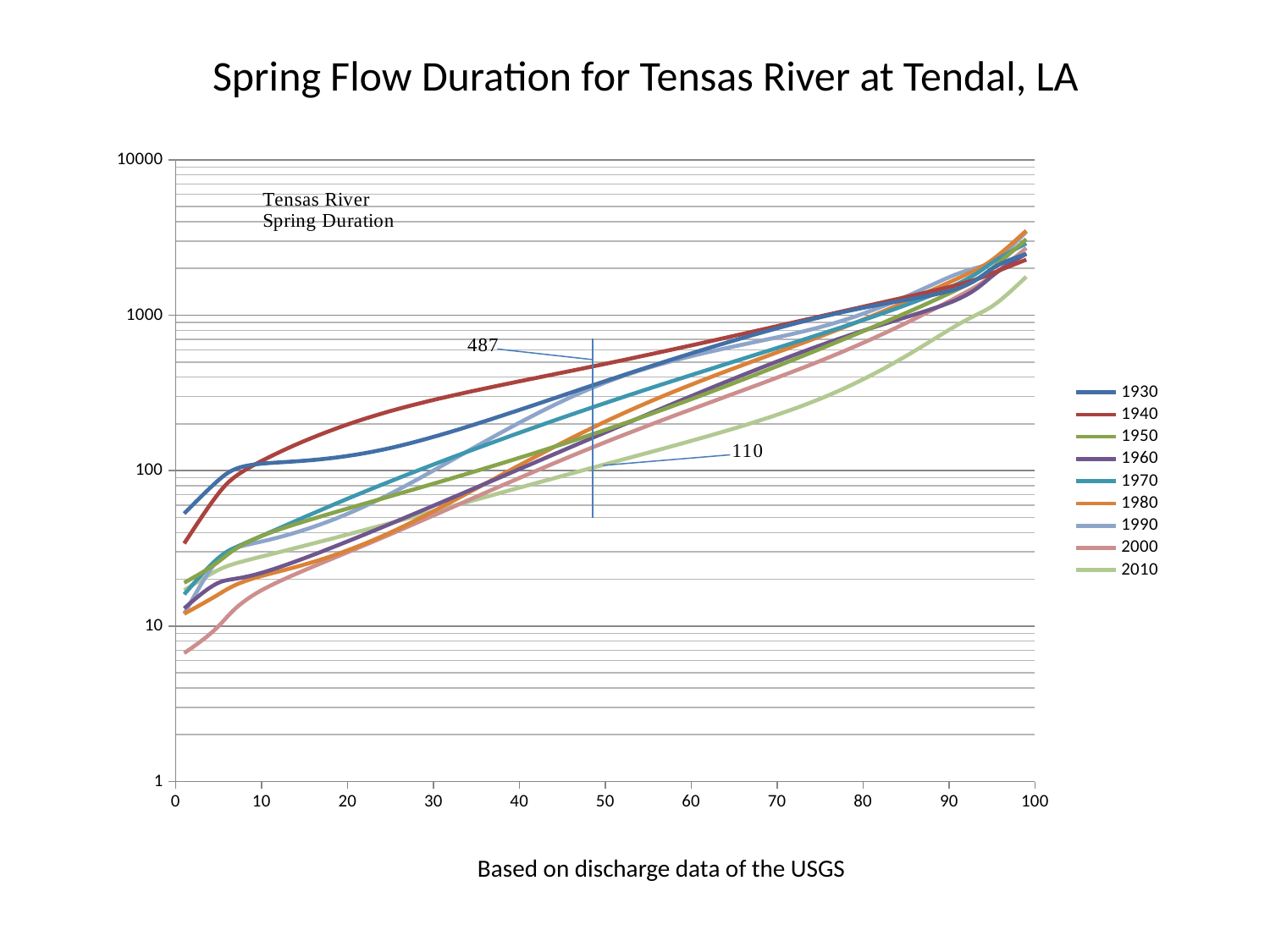
Which series has the highest value at 30 on the x axis? 1940 What value is annotated on the 2010 line near the 50 mark on the x axis? 110 Is the value of the 1940 line at 20 on the x axis greater or less than 100? greater What kind of chart is shown on the slide? line chart Which series has the lowest value at 70 on the x axis? 2010 How many series does the legend list? 9 At 30 on the x axis, which is larger: the 1940 line or the 1930 line? 1940 What value is annotated on the 1940 line near the 50 mark on the x axis? 487 What is the difference between the two annotated values, 487 and 110? 377 Do the lines generally rise or fall as the x axis increases from 0 to 100? rise What is the title of the chart on the slide? Spring Flow Duration for Tensas River at Tendal, LA Is the value of the 2010 line at 80 on the x axis greater or less than 1000? less